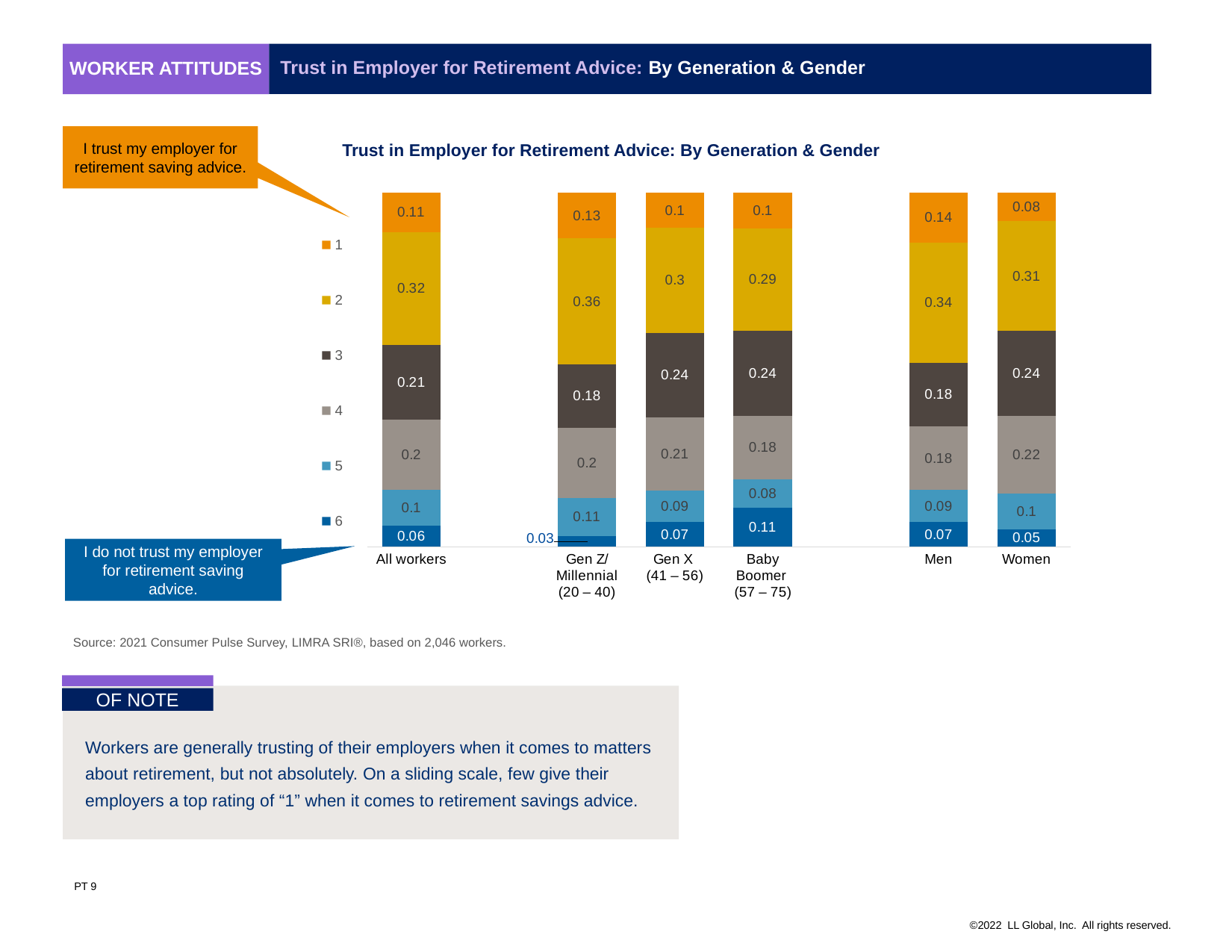
What is the title of the chart? Trust in Employer for Retirement Advice: By Generation & Gender Which category has the lowest value for series 6? Gen Z/Millennial (20 – 40) What kind of chart is shown on the slide? stacked bar chart Which category has the highest value for series 1? Men How many series does the legend list? 6 What is the value of series 2 for Gen Z/Millennial (20 – 40)? 0.36 What is the total of the stacked bar for All workers? 1 What is the difference between the series 2 values for Men and Women? 0.03 How many categories are shown along the x axis? 6 What is the value of series 1 for Men? 0.14 Which is larger, the series 3 value for Gen X (41 – 56) or for Men? Gen X (41 – 56) What is the value of series 6 for Baby Boomer (57 – 75)? 0.11